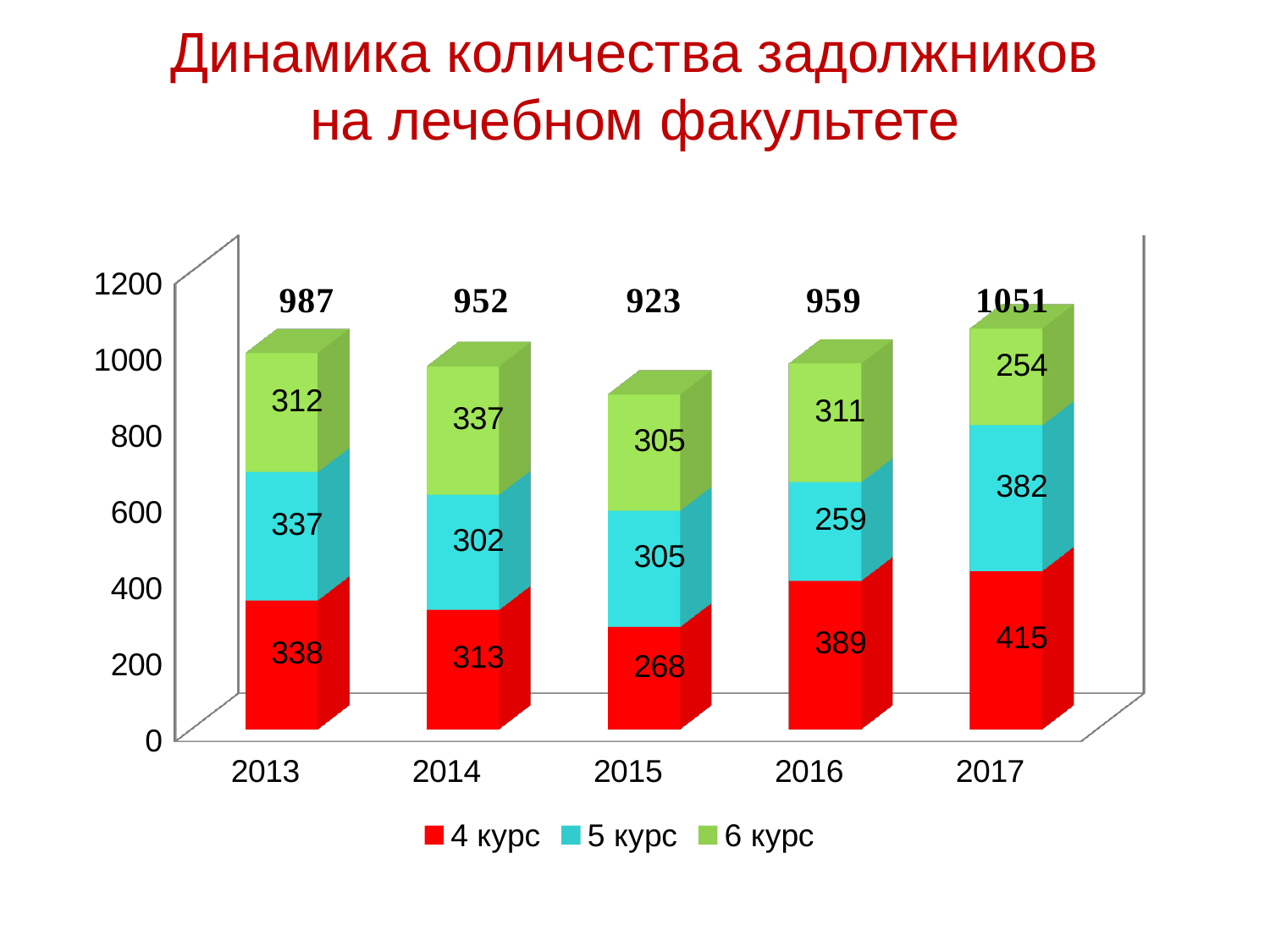
Which year has the highest total number of задолжники? 2017 What is the value for 4 курс in 2017? 415 What kind of chart is shown on the slide? Stacked bar chart How many series does the legend list? 3 What is the total of the stacked bar for 2015? 923 Which colour represents 6 курс in the chart? Green Which is larger: the 5 курс value in 2013 or the 5 курс value in 2014? 2013 Which year has the lowest total number of задолжники? 2015 How many years are shown on the x axis? 5 What is the value for 6 курс in 2014? 337 What is the difference between the 4 курс values for 2017 and 2015? 147 What is the value for 5 курс in 2016? 259